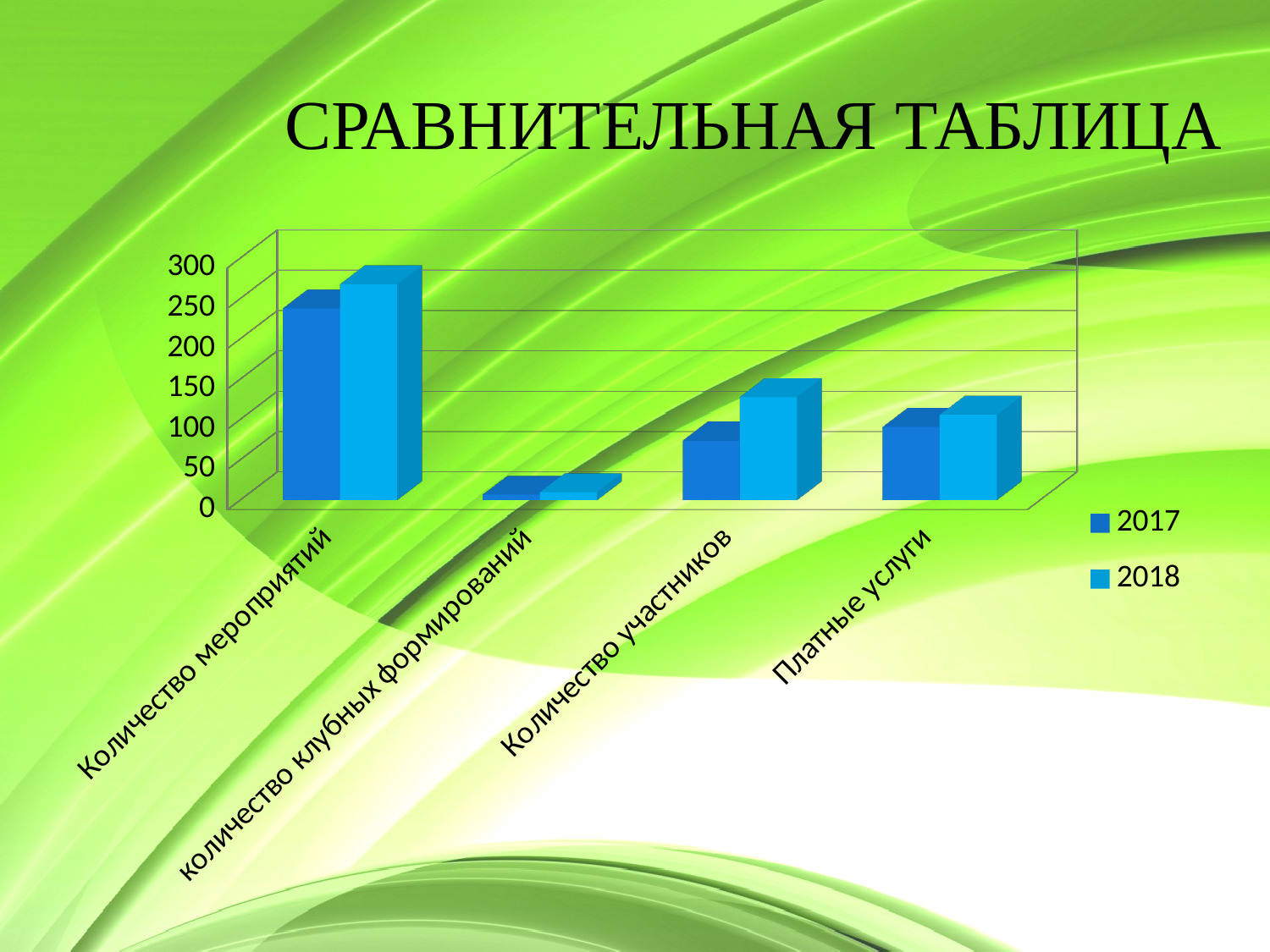
Which category has the lowest value for 2017? количество клубных формирований What kind of chart is shown on the slide? bar chart For Количество участников, which year has the larger value, 2017 or 2018? 2018 Is the 2017 value for Количество мероприятий greater or less than 200? greater What is the title of the slide containing the chart? СРАВНИТЕЛЬНАЯ ТАБЛИЦА Is the 2017 value for количество клубных формирований greater or less than 50? less Which category has the highest value for 2018? Количество мероприятий How many categories are shown on the x axis of the chart? 4 Is the 2018 value for Количество мероприятий greater or less than 250? greater Which years are listed in the chart legend? 2017 and 2018 How many series does the chart legend list? 2